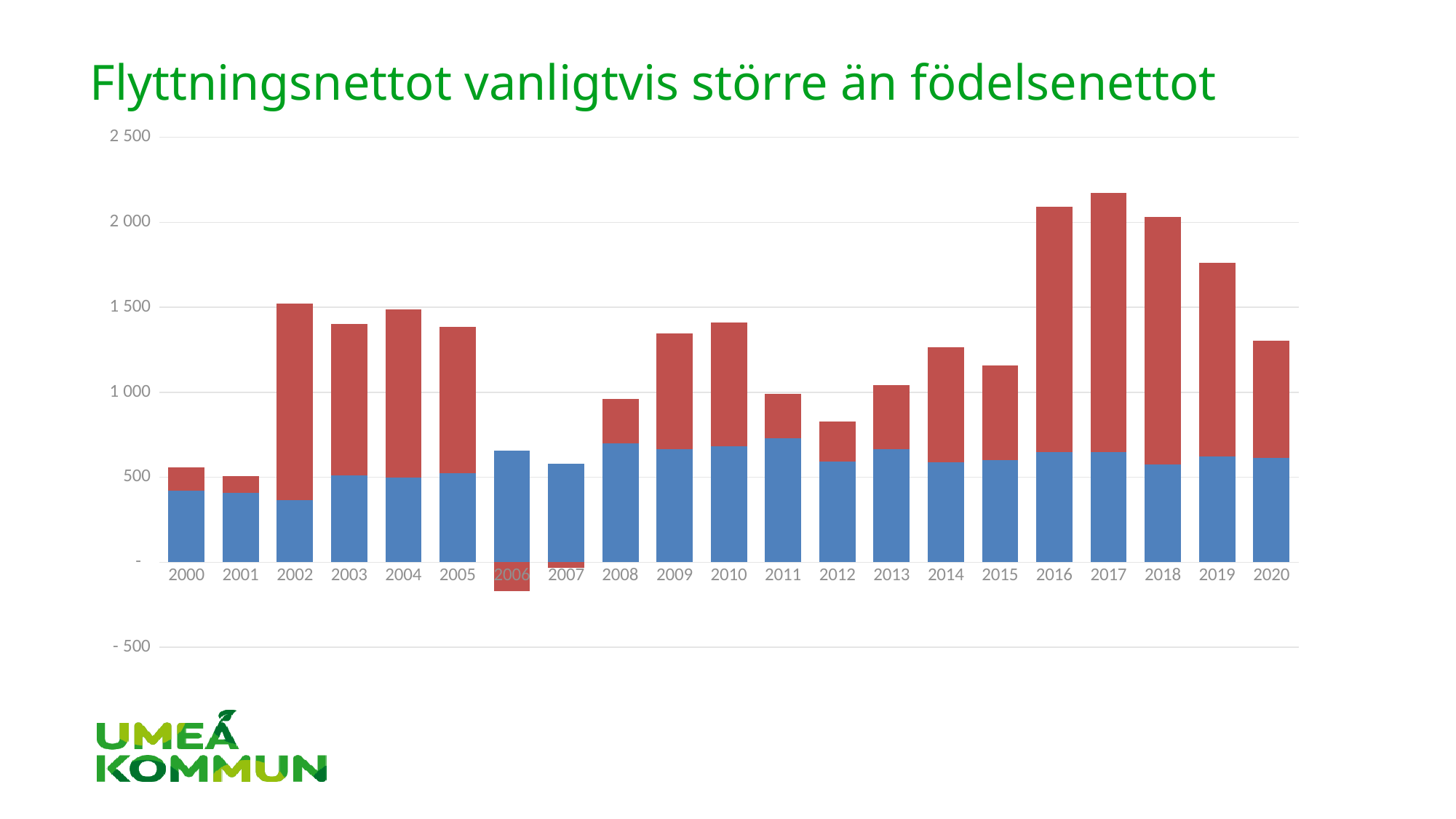
Is the total stacked value for 2012 greater or less than 1 000? less In which years does the red segment extend below zero? 2006 and 2007 What is the title of the chart slide? Flyttningsnettot vanligtvis större än födelsenettot Is the total stacked value for 2017 greater or less than 2 000? greater Is the total stacked value for 2020 greater or less than 1 000? greater Which year has the taller stacked bar, 2016 or 2017? 2017 What kind of chart is shown on the slide? Stacked bar chart Do the stacked bar totals rise or fall from 2017 to 2020? fall Which year has the tallest stacked bar in the chart? 2017 Which year has the taller stacked bar, 2014 or 2015? 2014 How many years are shown along the x axis of the chart? 21